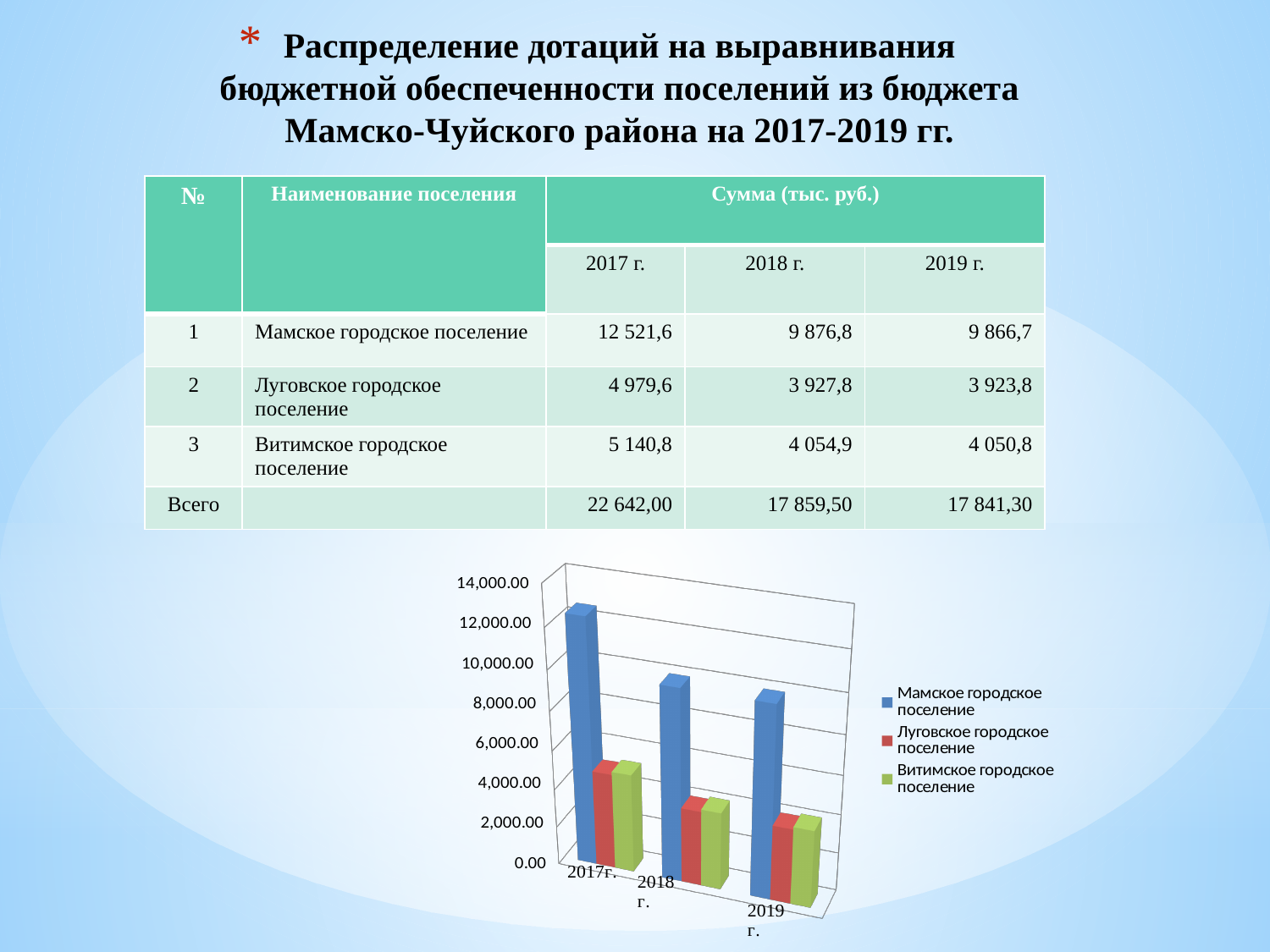
How many year categories are shown on the chart's x axis? 3 According to the slide, which is larger in 2017: Луговское городское поселение or Витимское городское поселение? Витимское городское поселение How many series does the chart legend list? 3 What type of chart is shown on the slide? bar chart Is the value for Мамское городское поселение in 2017 greater or less than 12,000.00? greater Which series is shown in blue on the chart? Мамское городское поселение Which series has the highest bar on the chart? Мамское городское поселение Is the value for Луговское городское поселение in 2017 greater or less than 4,000.00? greater According to the slide, what is the amount (тыс. руб.) for Мамское городское поселение in 2017? 12 521,6 According to the slide, what is the total (Всего) amount for 2017? 22 642,00 Is the value for Мамское городское поселение in 2019 greater or less than 10,000.00? less Do the values for Мамское городское поселение rise or fall from 2017 to 2019? fall